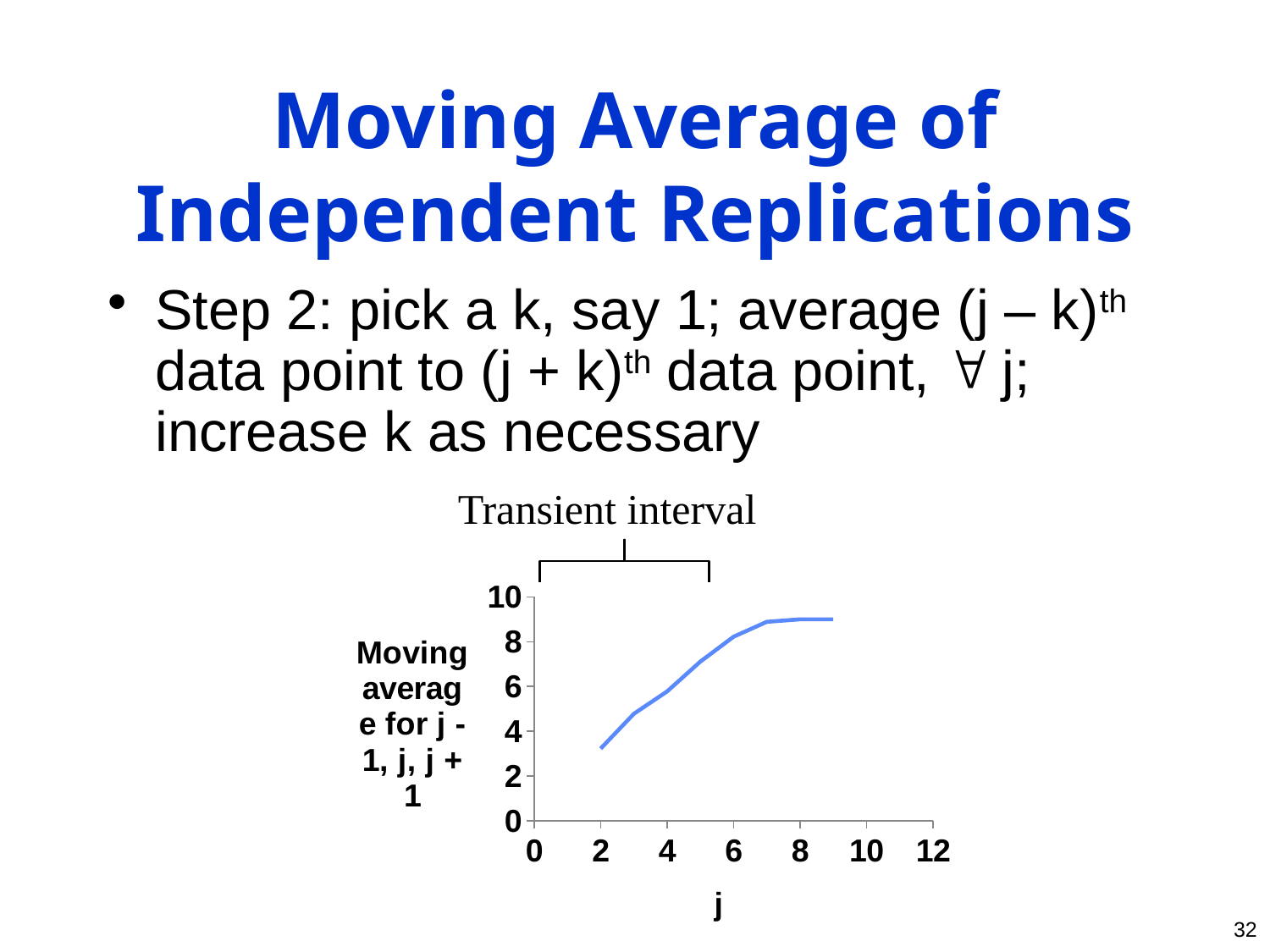
What kind of chart is shown on the slide? line chart Is the moving average at j = 8 greater or less than 8? greater Is the moving average at j = 2 greater or less than 4? less Is the moving average at j = 9 greater or less than 10? less Which has the larger moving average, j = 2 or j = 8? j = 8 At which value of j is the moving average lowest? 2 What is the label on the x axis of the chart? j What interval is marked by the bracket above the chart? Transient interval Do the values of the moving average rise or fall as j increases? rise